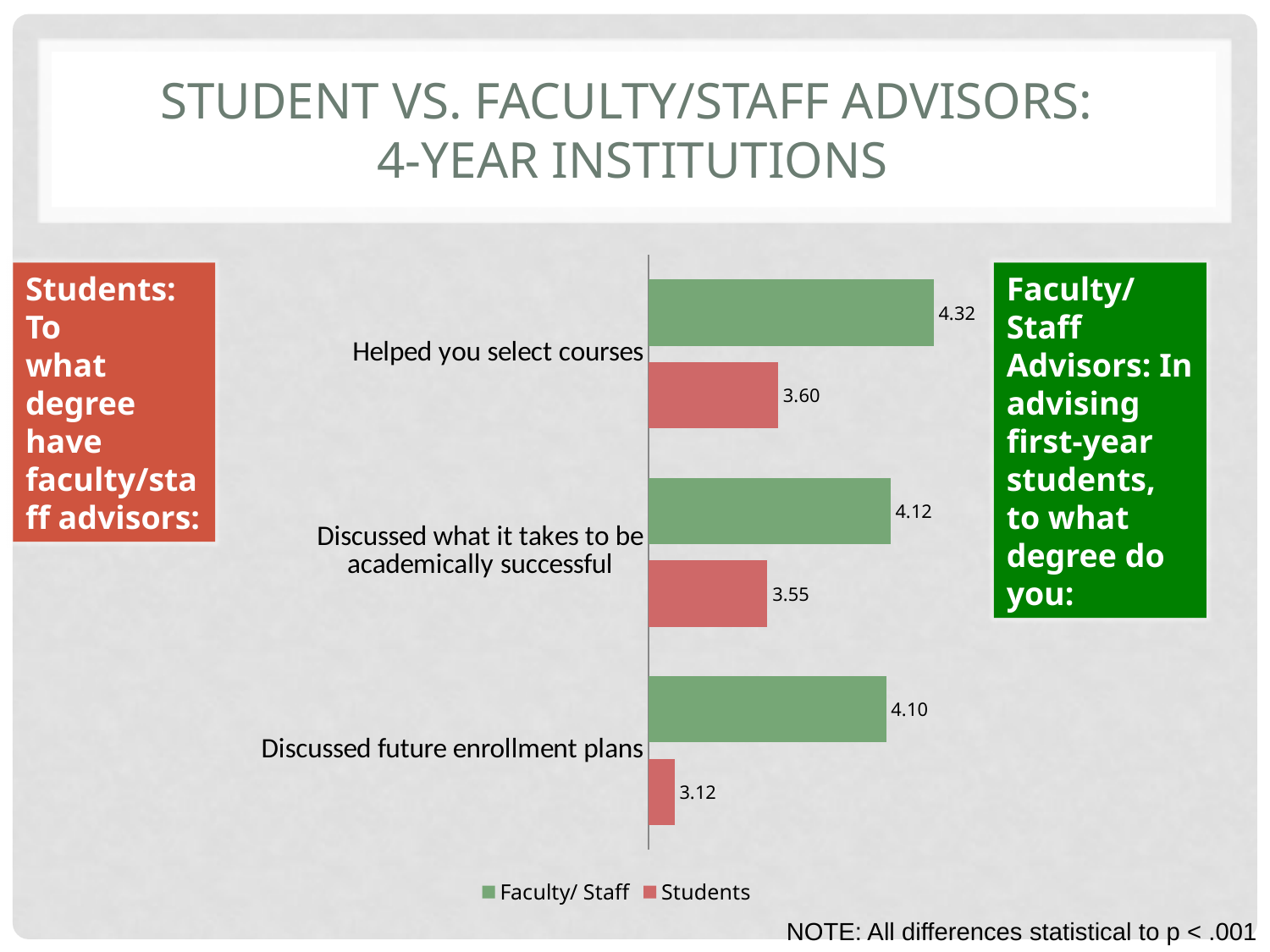
What is the Students value for "Discussed future enrollment plans"? 3.12 What is the Faculty/ Staff value for "Discussed future enrollment plans"? 4.10 For "Discussed what it takes to be academically successful", which is larger: the Faculty/ Staff value or the Students value? Faculty/ Staff What is the Faculty/ Staff value for "Helped you select courses"? 4.32 What is the difference between the Faculty/ Staff and Students values for "Discussed future enrollment plans"? 0.98 Which category has the highest Faculty/ Staff value? Helped you select courses What kind of chart is shown on the slide? Bar chart Which category has the lowest Students value? Discussed future enrollment plans How many categories are shown in the chart? 3 What is the Students value for "Discussed what it takes to be academically successful"? 3.55 What is the difference between the Faculty/ Staff and Students values for "Helped you select courses"? 0.72 How many series does the legend list? 2